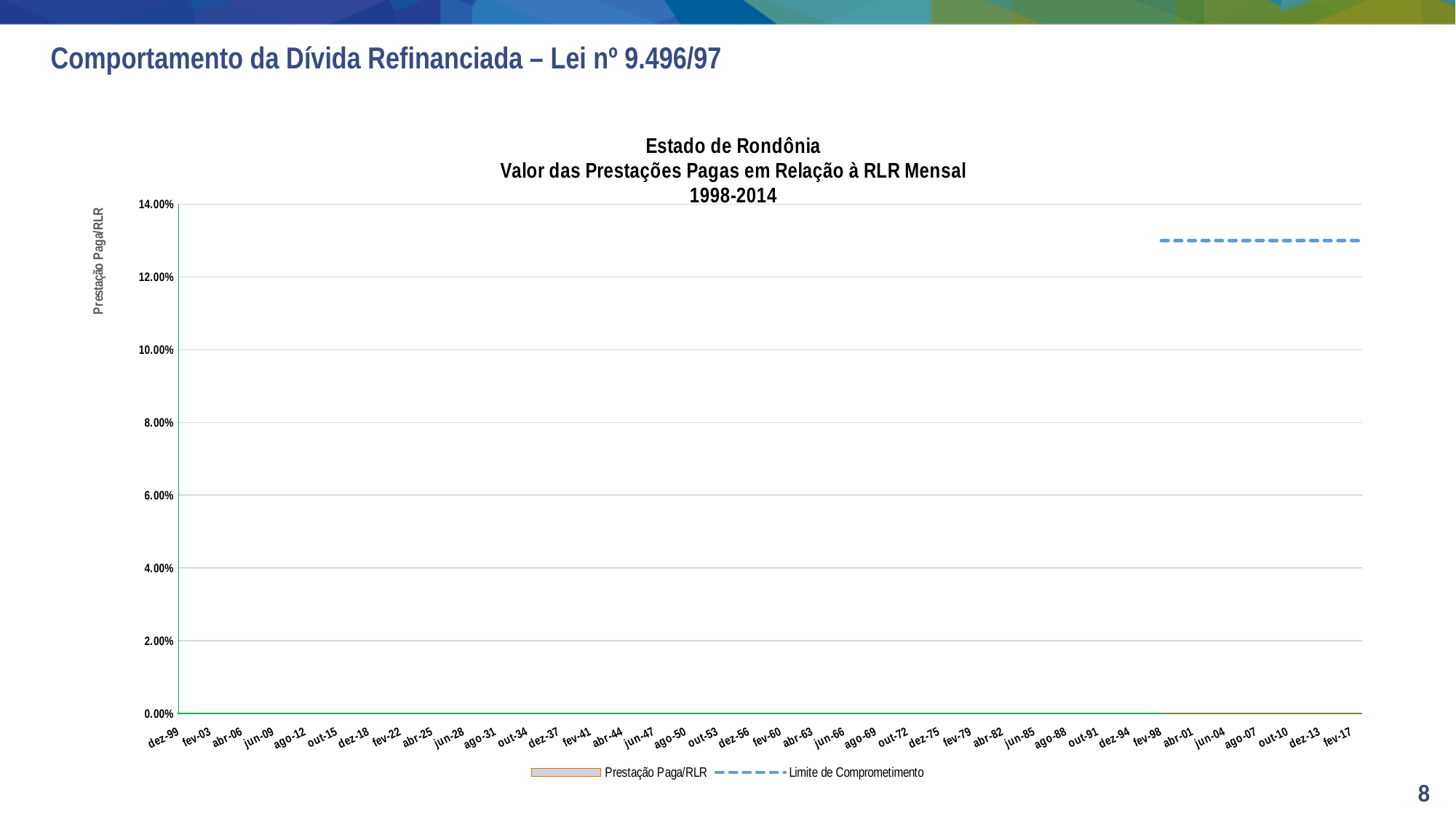
Is the value of the Limite de Comprometimento line greater or less than 12.00%? greater Which two series are listed in the legend? Prestação Paga/RLR and Limite de Comprometimento How many series does the legend list? 2 What is the lowest tick value shown on the y axis? 0.00% Is the value of the Limite de Comprometimento line greater or less than 14.00%? less Is the value of the Limite de Comprometimento line greater or less than 10.00%? greater What is the highest tick value shown on the y axis? 14.00% Which state is named in the chart title? Estado de Rondônia Does the Limite de Comprometimento line rise, fall, or stay flat along the x axis where it is drawn? stays flat